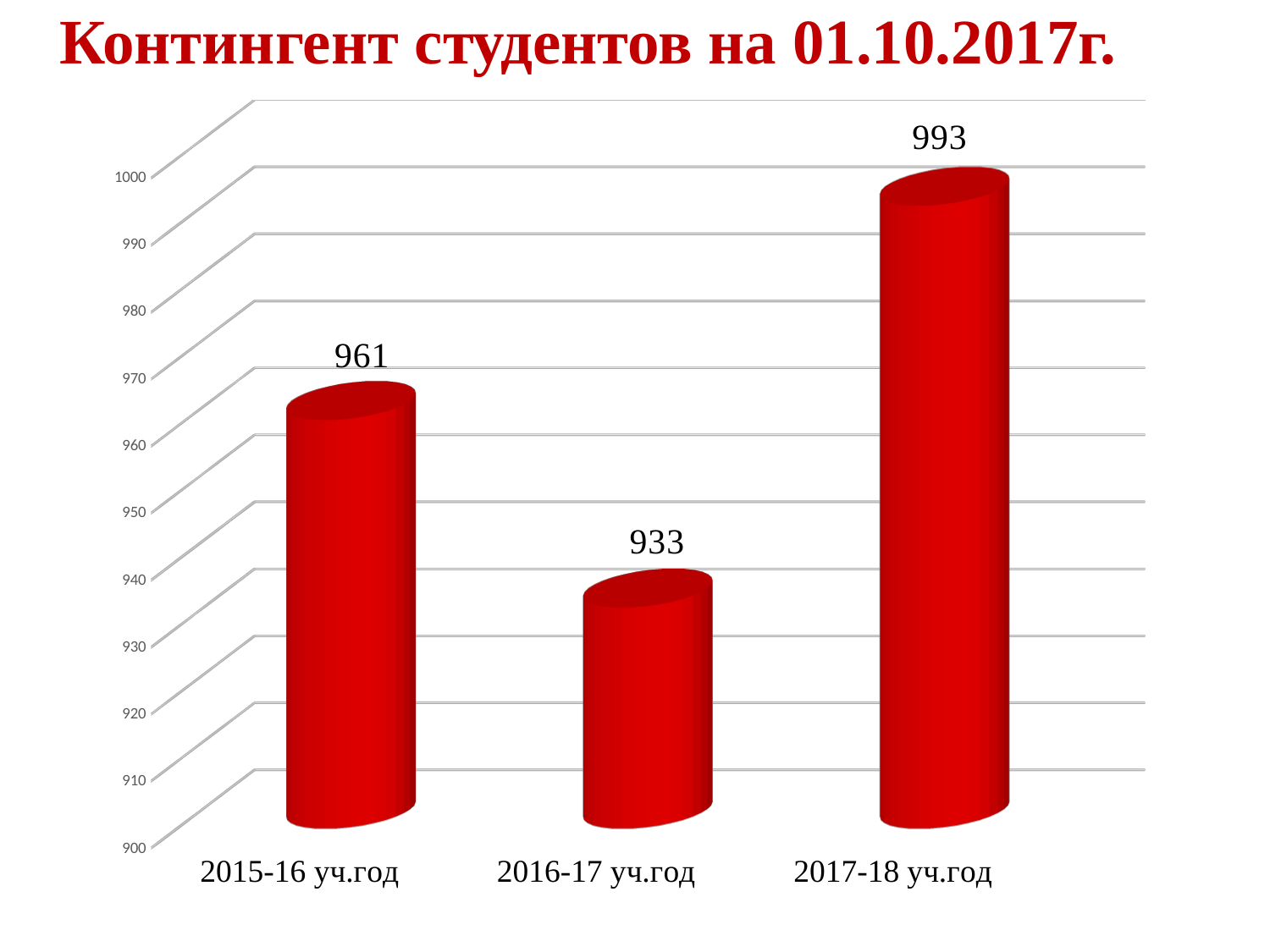
Which is larger, the value for 2015-16 уч.год or 2017-18 уч.год? 2017-18 уч.год Is the value for 2016-17 уч.год greater or less than 950? less Which academic year has the lowest value? 2016-17 уч.год What is the difference between the values for 2017-18 уч.год and 2016-17 уч.год? 60 What is the difference between the values for 2015-16 уч.год and 2016-17 уч.год? 28 What is the value for 2015-16 уч.год? 961 What is the title of the chart? Контингент студентов на 01.10.2017г. What kind of chart is shown on the slide? bar chart How many academic years are shown on the chart? 3 What is the value for 2017-18 уч.год? 993 What is the value for 2016-17 уч.год? 933 Which academic year has the highest value? 2017-18 уч.год